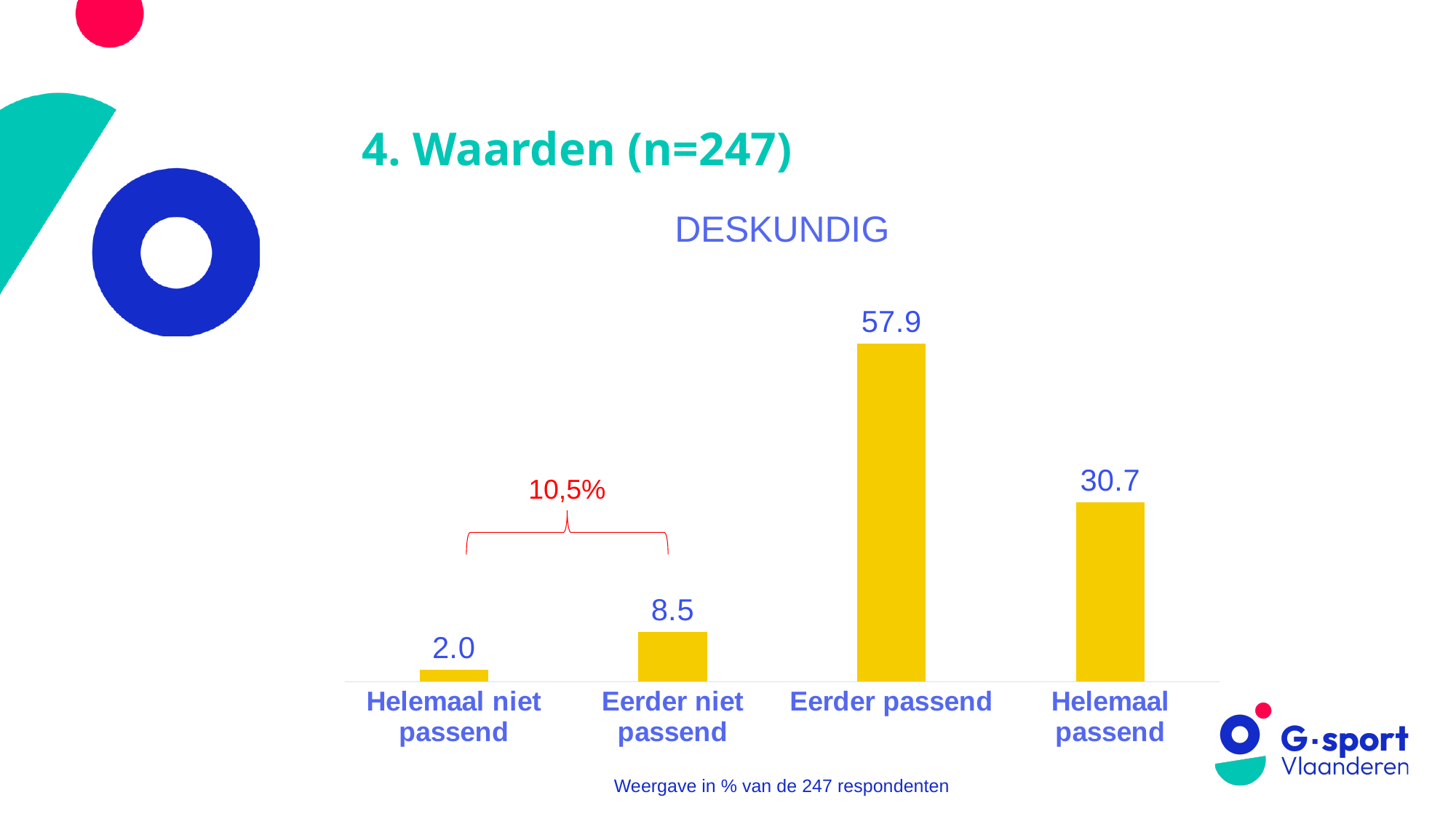
Which is larger, the value for "Eerder niet passend" or the value for "Helemaal passend"? Helemaal passend How many categories are shown in the chart? 4 Which category has the lowest value? Helemaal niet passend Which category has the highest value? Eerder passend What is the value for "Helemaal passend"? 30.7 What is the title of the chart? DESKUNDIG What is the value for "Helemaal niet passend"? 2.0 What is the difference between the values for "Eerder passend" and "Helemaal passend"? 27.2 What kind of chart is shown on the slide? Bar chart What combined percentage is shown in red above the first two bars? 10,5% What is the value for "Eerder niet passend"? 8.5 What is the value for "Eerder passend"? 57.9